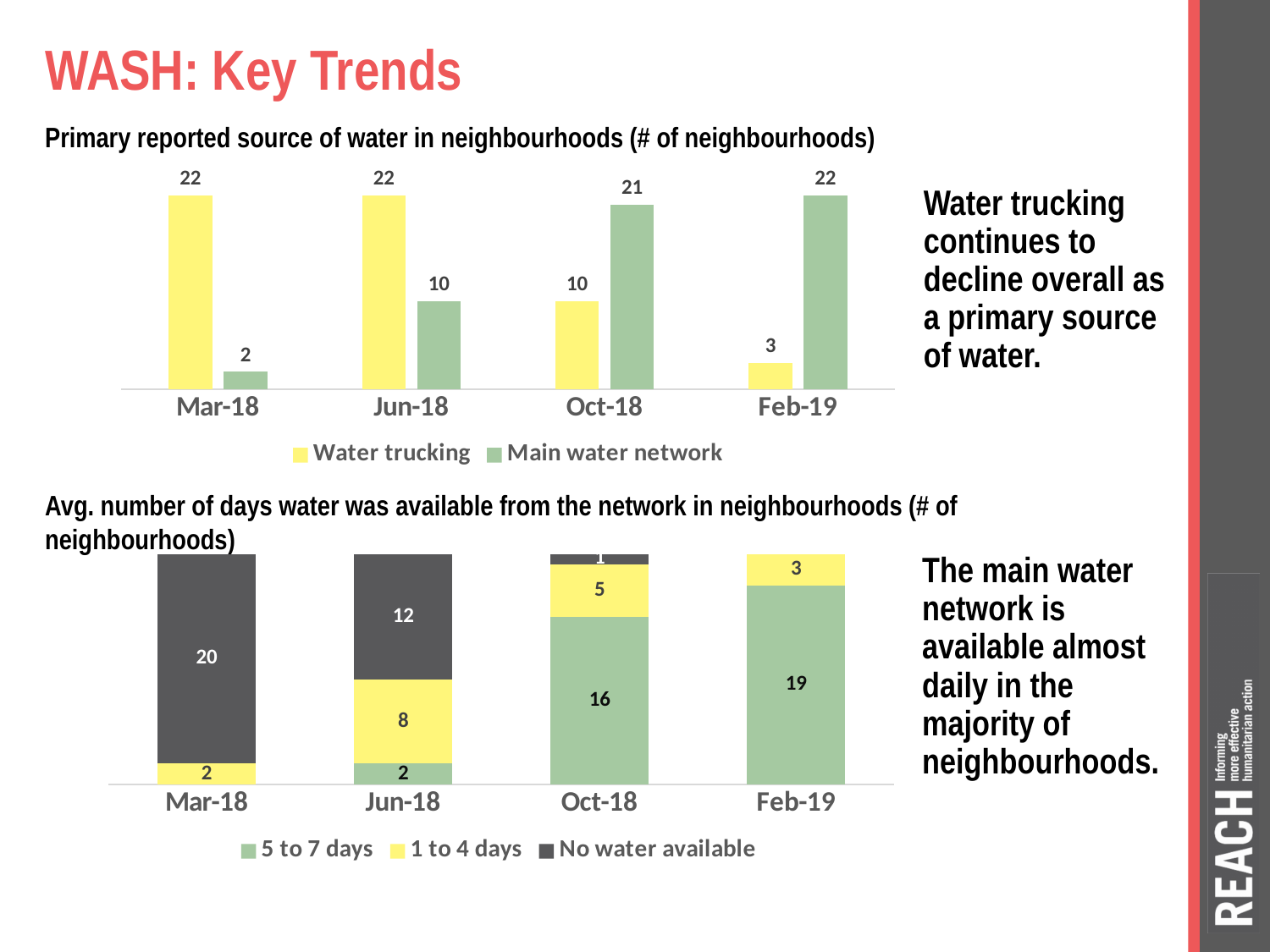
In the top chart (Primary reported source of water), what is the value for Main water network in Oct-18? 21 In the top chart (Primary reported source of water), does the Main water network series rise or fall from Mar-18 to Feb-19? Rise In the top chart (Primary reported source of water), which is larger in Feb-19: Water trucking or Main water network? Main water network In the bottom chart (Avg. number of days water was available), what is the value for 5 to 7 days in Oct-18? 16 In the bottom chart (Avg. number of days water was available), how many periods are shown on the x axis? 4 In the top chart (Primary reported source of water), how many series does the legend list? 2 In the top chart (Primary reported source of water), what is the value for Water trucking in Mar-18? 22 In the bottom chart (Avg. number of days water was available), what is the value for No water available in Jun-18? 12 In the top chart (Primary reported source of water), what is the difference between Water trucking and Main water network in Jun-18? 12 In the top chart (Primary reported source of water), in which period is Water trucking lowest? Feb-19 What kind of chart is the bottom chart (Avg. number of days water was available)? Stacked bar chart In the bottom chart (Avg. number of days water was available), what is the total of the stacked bar for Jun-18? 22